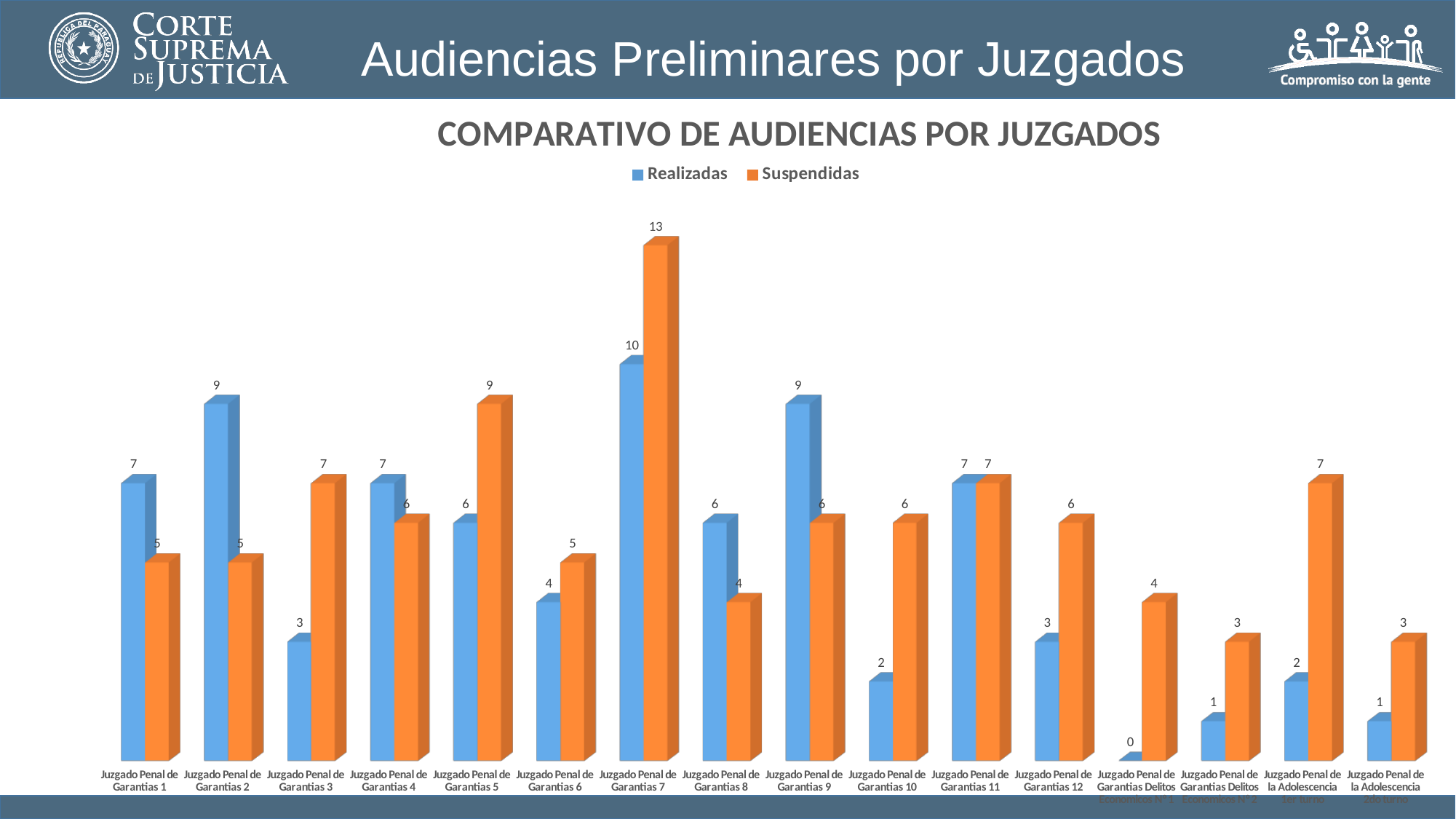
Which juzgado has the highest Realizadas value? Juzgado Penal de Garantias 7 What are the two series named in the chart legend? Realizadas and Suspendidas What is the Suspendidas value for Juzgado Penal de Garantias 5? 9 For Juzgado Penal de Garantias 7, what is the difference between Suspendidas and Realizadas? 3 How many juzgados (categories) are shown on the x axis of the chart? 16 Which juzgado has the highest Suspendidas value? Juzgado Penal de Garantias 7 How many series does the legend list in the chart? 2 What kind of chart is shown on the slide? Bar chart For Juzgado Penal de Garantias 10, what is the difference between Suspendidas and Realizadas? 4 What is the Realizadas value for Juzgado Penal de Garantias 2? 9 For Juzgado Penal de Garantias 3, which is larger: Realizadas or Suspendidas? Suspendidas What is the Realizadas value for Juzgado Penal de Garantias 12? 3